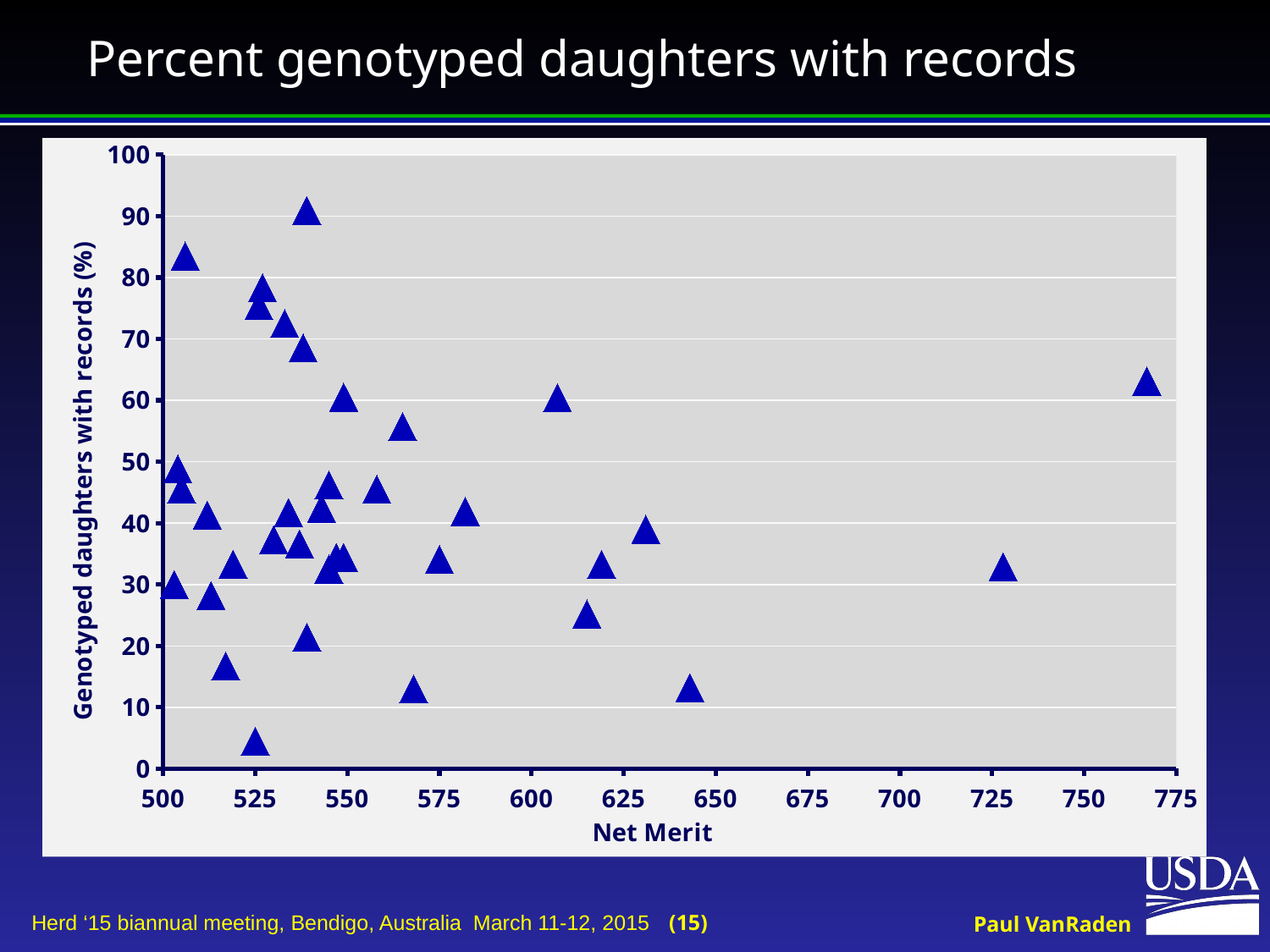
What is the title of the x axis of the chart? Net Merit Which has the higher percent of genotyped daughters with records: the point near Net Merit 725 or the point closest to Net Merit 775? the point closest to Net Merit 775 Which has the higher percent of genotyped daughters with records: the point near Net Merit 500 at the top left or the point near Net Merit 525 at the bottom? the point near Net Merit 500 at the top left Is the lowest plotted value of genotyped daughters with records greater or less than 10? less What kind of chart is shown on the slide? scatter plot What is the title of the y axis of the chart? Genotyped daughters with records (%) Is the value for the point plotted near Net Merit 575 greater or less than 40? less Is the value for the point plotted just above Net Merit 600 greater or less than 50? greater